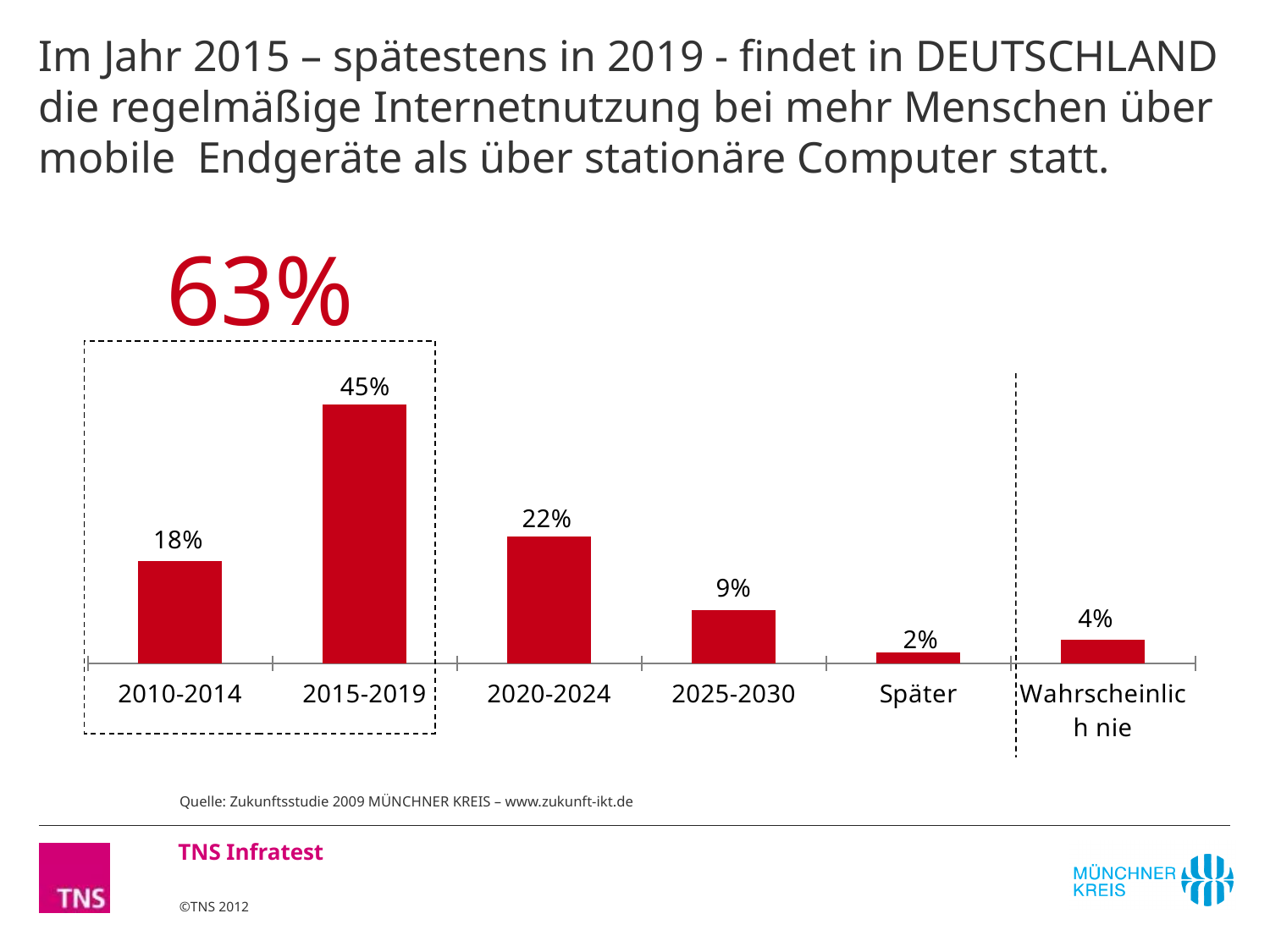
What is the value for 2010-2014? 18% What is the combined value of 2010-2014 and 2015-2019 shown in the dashed box? 63% What is the source cited below the chart? Zukunftsstudie 2009 MÜNCHNER KREIS – www.zukunft-ikt.de What is the difference between the values for 2015-2019 and 2020-2024? 23% Which category has the highest value? 2015-2019 What kind of chart is shown on the slide? Bar chart What is the value for 'Wahrscheinlich nie'? 4% Which category has the lowest value? Später What is the value for 2020-2024? 22% Which is larger, the value for 2010-2014 or the value for 2025-2030? 2010-2014 How many categories are shown on the x axis? 6 What is the value for 2015-2019? 45%